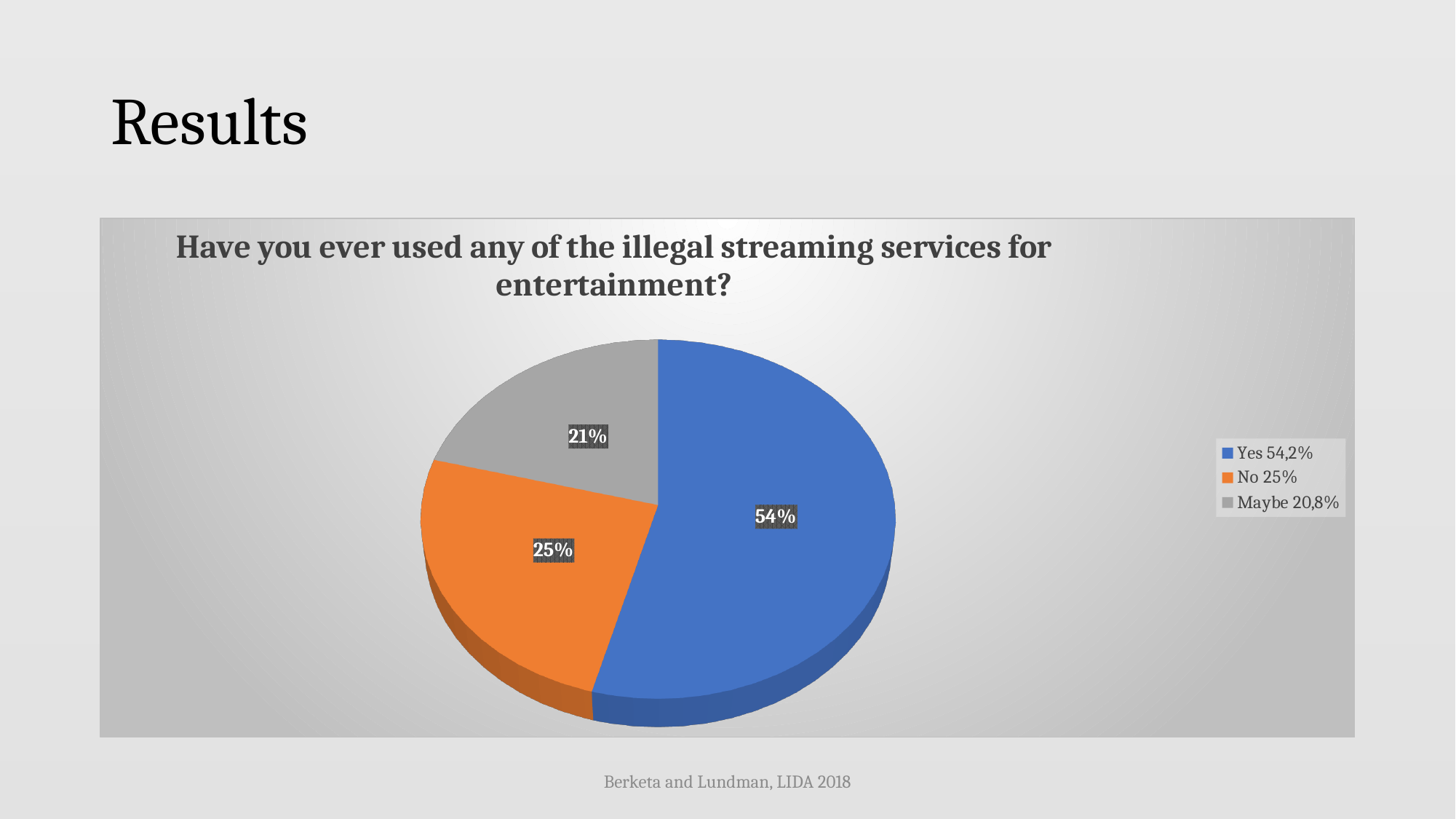
Which answer has the smallest share of the pie? Maybe Which answer has the largest share of the pie? Yes What percentage is shown on the data label for the 'No' slice? 25% Which slice is larger, 'No' or 'Maybe'? No What is the title of the chart? Have you ever used any of the illegal streaming services for entertainment? What percentage is shown on the data label for the 'Maybe' slice? 21% What type of chart is shown on the slide? pie chart What colour is the 'Yes' slice? blue What percentage is shown on the data label for the 'Yes' slice? 54% According to the legend, what is the exact percentage for 'Yes'? 54,2% According to the legend, what is the exact percentage for 'Maybe'? 20,8% How many slices does the pie chart have? 3